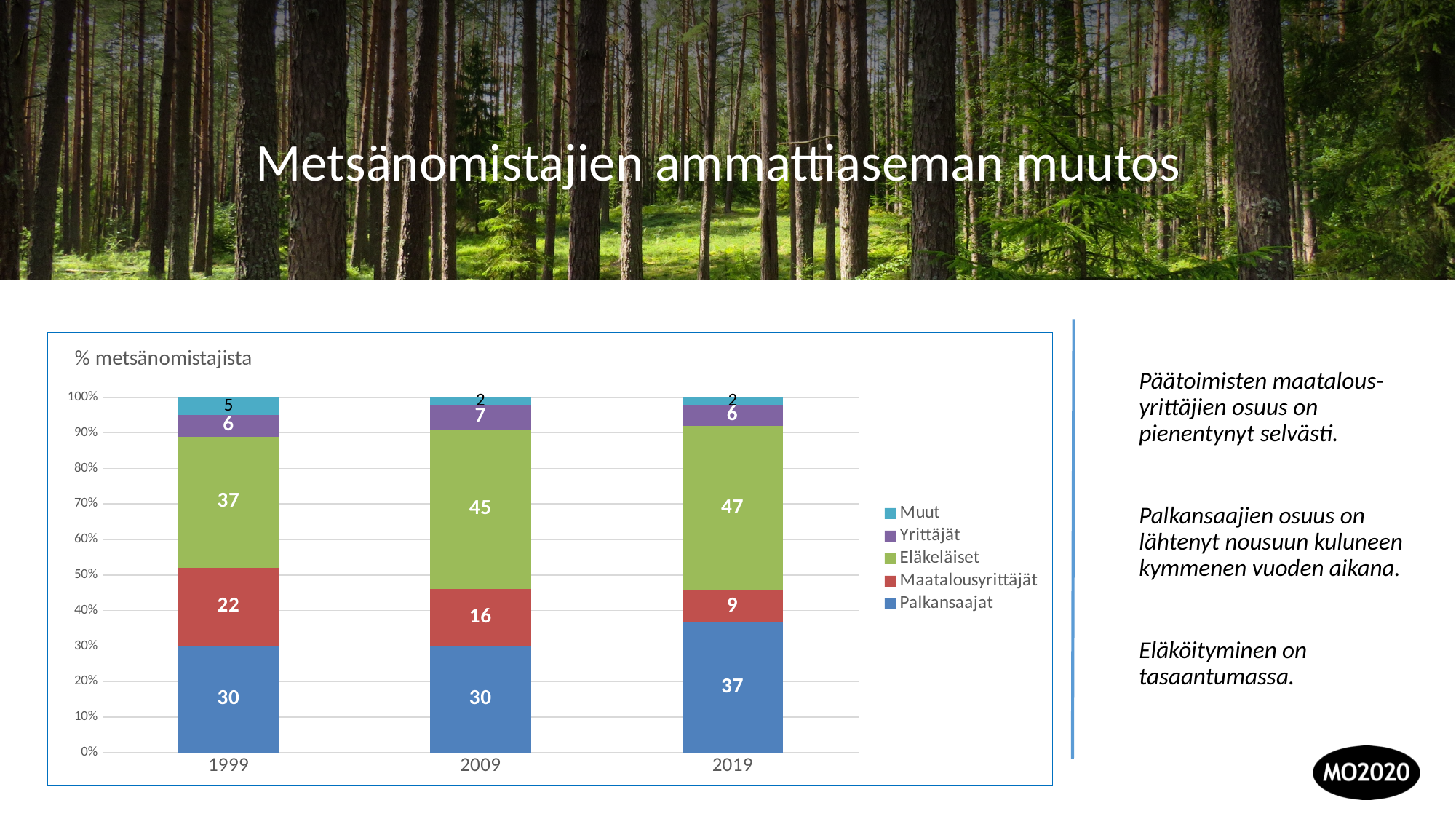
What is the value for Palkansaajat in 2009? 30 How many series does the legend list? 5 Does the value for Palkansaajat rise or fall from 2009 to 2019? rise What is the value for Maatalousyrittäjät in 1999? 22 What kind of chart is shown? stacked bar chart Which is larger, the Yrittäjät value in 2009 or in 2019? 2009 In which year is the value for Eläkeläiset highest? 2019 What is the value for Muut in 1999? 5 How many years are shown on the x axis? 3 In which year is the value for Maatalousyrittäjät lowest? 2019 What is the difference between the Maatalousyrittäjät values for 1999 and 2019? 13 What is the value for Eläkeläiset in 2019? 47